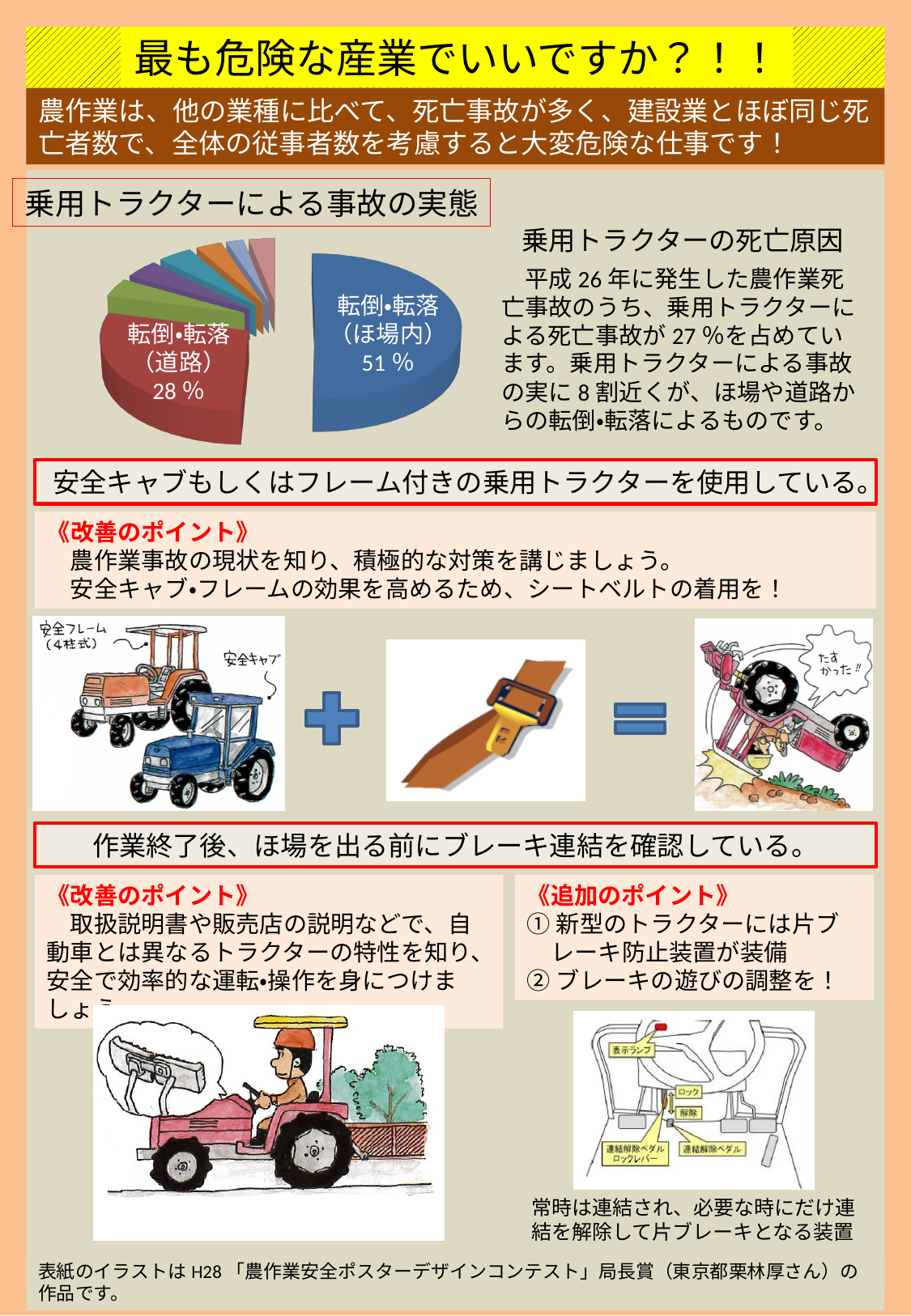
What kind of chart is shown on the slide? Pie chart What is the combined share of the two labeled slices, 転倒•転落（ほ場内） and 転倒•転落（道路）? 79 % What percentage does the 転倒•転落（道路） slice of the pie chart represent? 28 % Is the share of the 転倒•転落（ほ場内） slice greater or less than 50%? greater What colour is the 転倒•転落（ほ場内） slice of the pie chart? Blue Which labeled slice of the pie chart is the largest? 転倒•転落（ほ場内） What colour is the 転倒•転落（道路） slice of the pie chart? Red What is the difference in percentage points between the 転倒•転落（ほ場内） slice and the 転倒•転落（道路） slice? 23 % Which is larger in the pie chart: 転倒•転落（ほ場内） or 転倒•転落（道路）? 転倒•転落（ほ場内） What percentage does the 転倒•転落（ほ場内） slice of the pie chart represent? 51 %